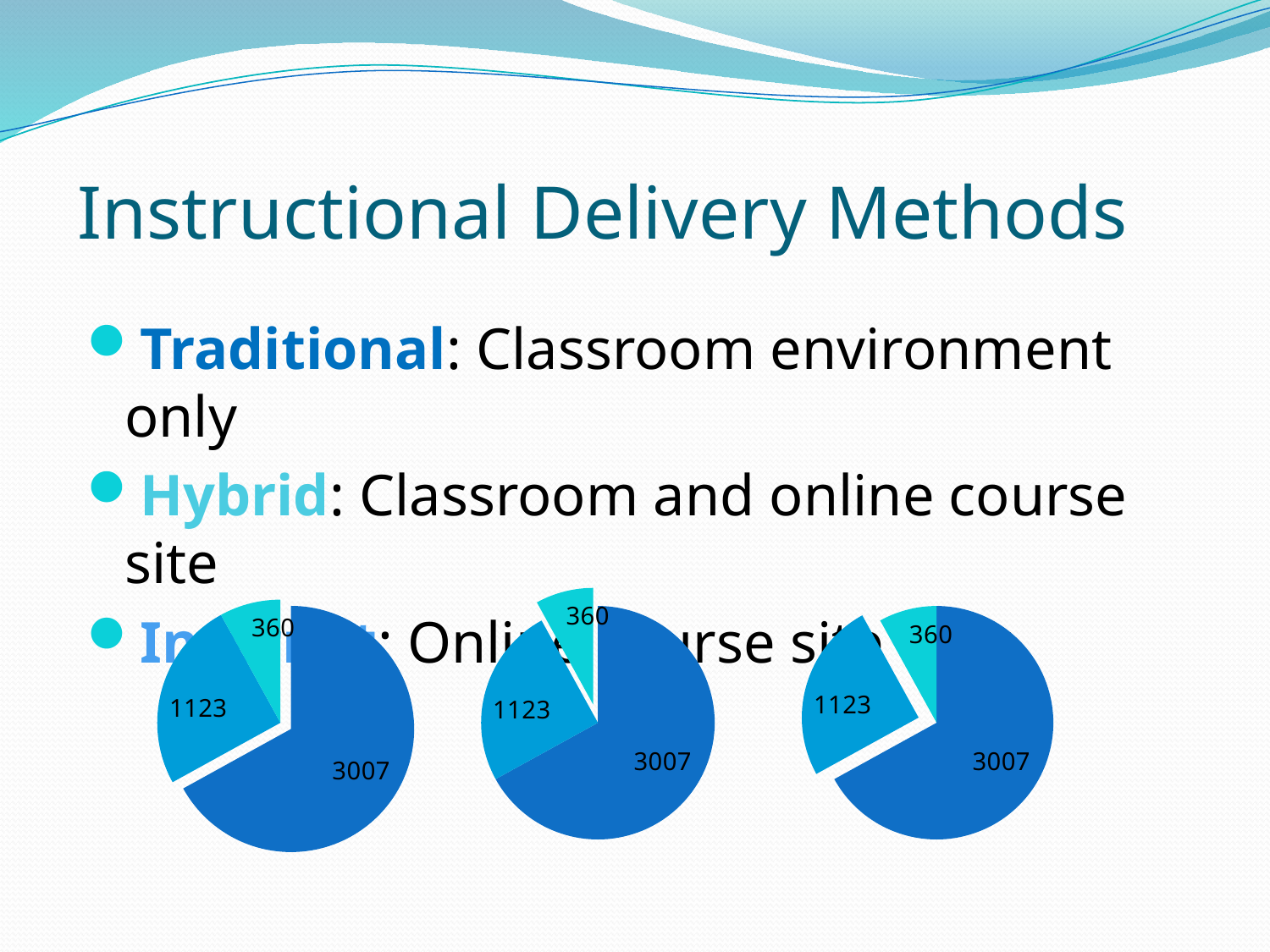
In the leftmost pie chart, which is larger: the slice labelled 1123 or the slice labelled 360? 1123 In the rightmost pie chart, what is the total of all three slices? 4490 In the leftmost pie chart, what is the difference between the largest slice (3007) and the second-largest slice (1123)? 1884 In the rightmost pie chart, what colour is the largest slice? dark blue How many pie charts are shown on the slide? 3 Do the three pie charts on the slide show the same three values? yes In the middle pie chart, what is the value of the largest slice? 3007 In the middle pie chart, what is the difference between the slice labelled 1123 and the slice labelled 360? 763 In the rightmost pie chart, what is the value of the smallest slice? 360 What kind of chart is the leftmost chart on the slide? pie chart How many slices does the leftmost pie chart have? 3 In the middle pie chart, what share of the total does the slice labelled 3007 represent, to the nearest whole percent? 67%